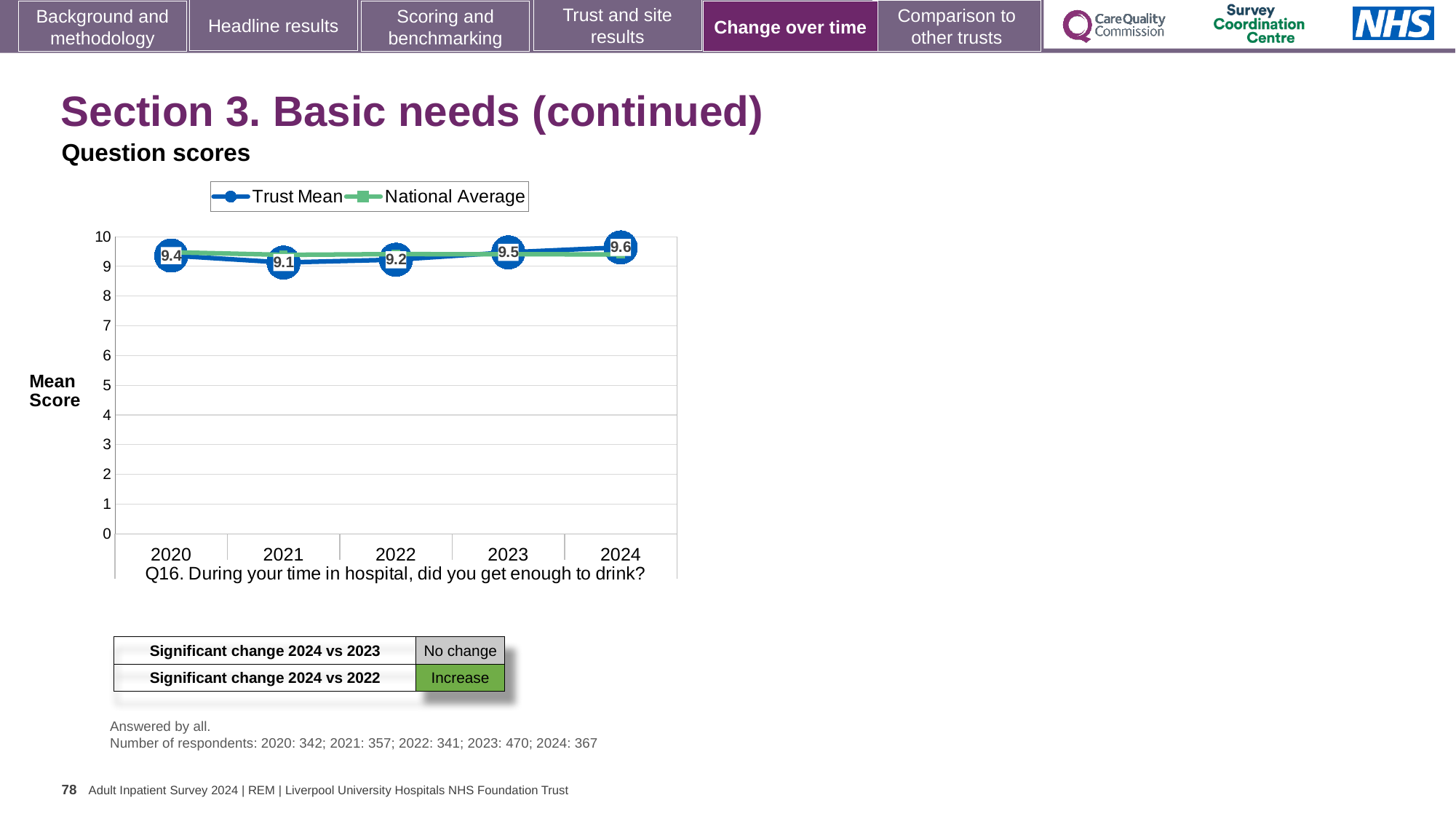
How many years are plotted on the x axis? 5 Does the Trust Mean score rise or fall from 2021 to 2024? Rise In which year is the Trust Mean score lowest? 2021 What is the difference between the Trust Mean scores for 2024 and 2021? 0.5 In which year is the Trust Mean score highest? 2024 Is the National Average value for 2022 greater or less than 8? greater Which year has the larger Trust Mean score, 2020 or 2021? 2020 What is the Trust Mean score for 2022? 9.2 How many series does the legend list? 2 What kind of chart is shown on the slide? Line chart What is the Trust Mean score for 2020? 9.4 What is the Trust Mean score for 2024? 9.6